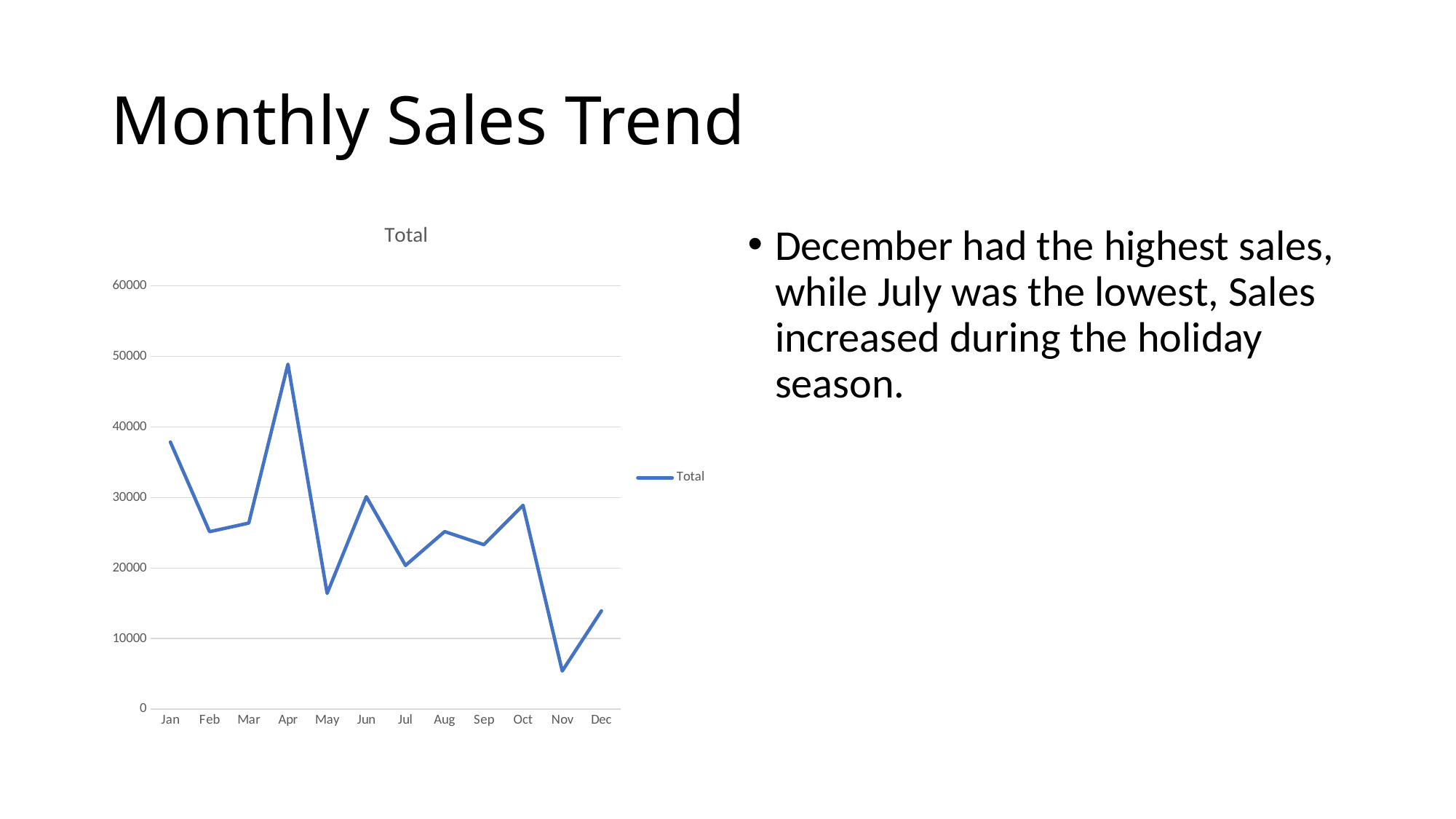
How many months are plotted on the x axis? 12 Which is larger, the value for Jan or the value for Feb? Jan What is the title of the chart? Total Which is larger, the value for Nov or the value for Dec? Dec Which month has the highest value on the chart? Apr Is the value for Jan greater or less than 30000? greater Is the value for Apr greater or less than 40000? greater What kind of chart is shown on the slide? line chart Which month has the lowest value on the chart? Nov How many series does the legend list? 1 Is the value for Nov greater or less than 10000? less